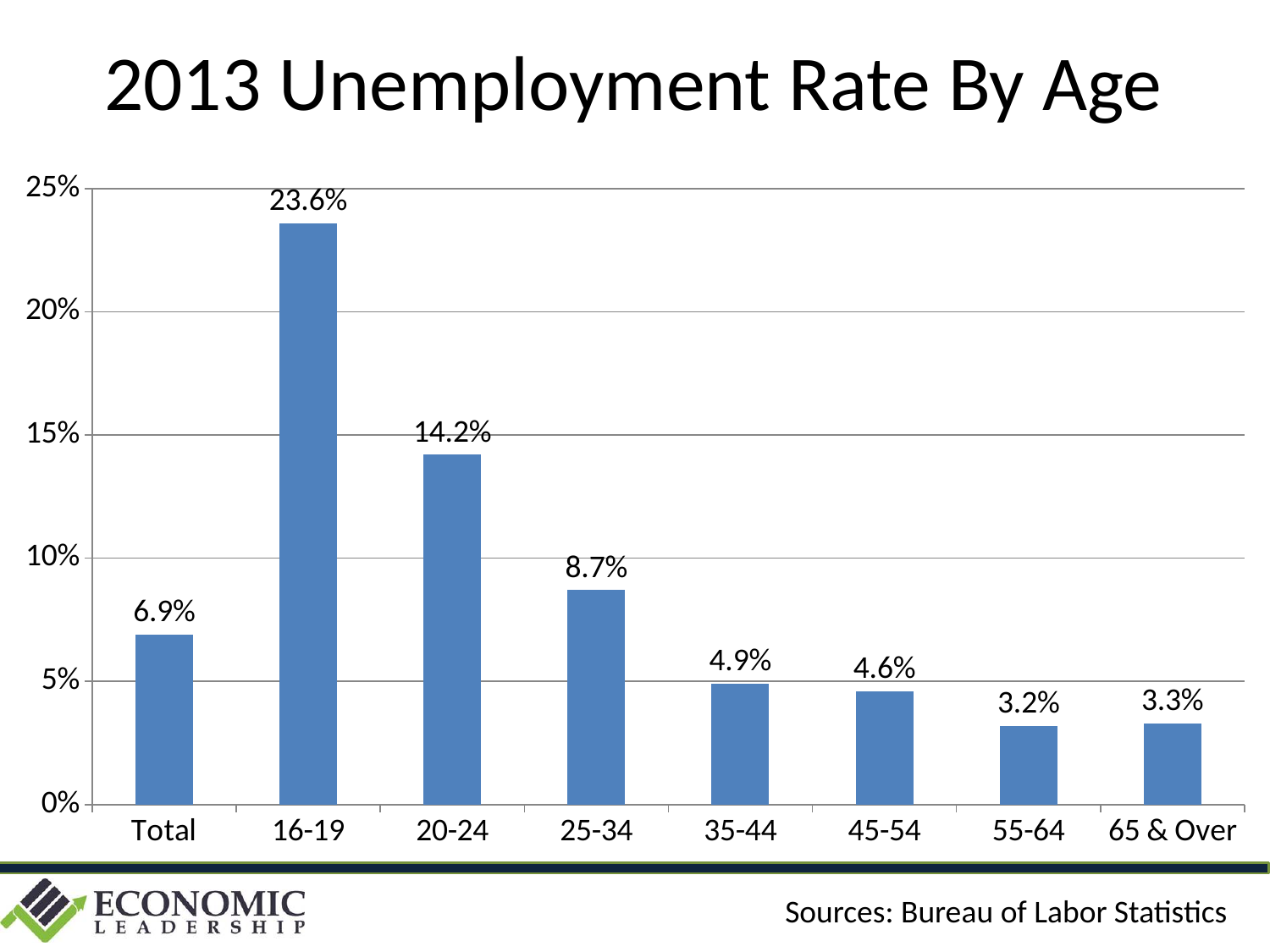
What is the title of the chart? 2013 Unemployment Rate By Age Which age group has the lowest unemployment rate? 55-64 What is the unemployment rate for the 16-19 age group? 23.6% What is the unemployment rate for the 45-54 age group? 4.6% What kind of chart is shown on the slide? Bar chart What is the difference between the unemployment rates for the 16-19 and 20-24 age groups? 9.4% Which has a higher unemployment rate, the 35-44 age group or the 45-54 age group? 35-44 What is the unemployment rate for the Total category? 6.9% How many categories are shown on the x axis? 8 Is the unemployment rate for the 20-24 age group greater or less than 15%? less Which age group has the highest unemployment rate? 16-19 What is the difference between the unemployment rates for the 25-34 age group and the Total? 1.8%